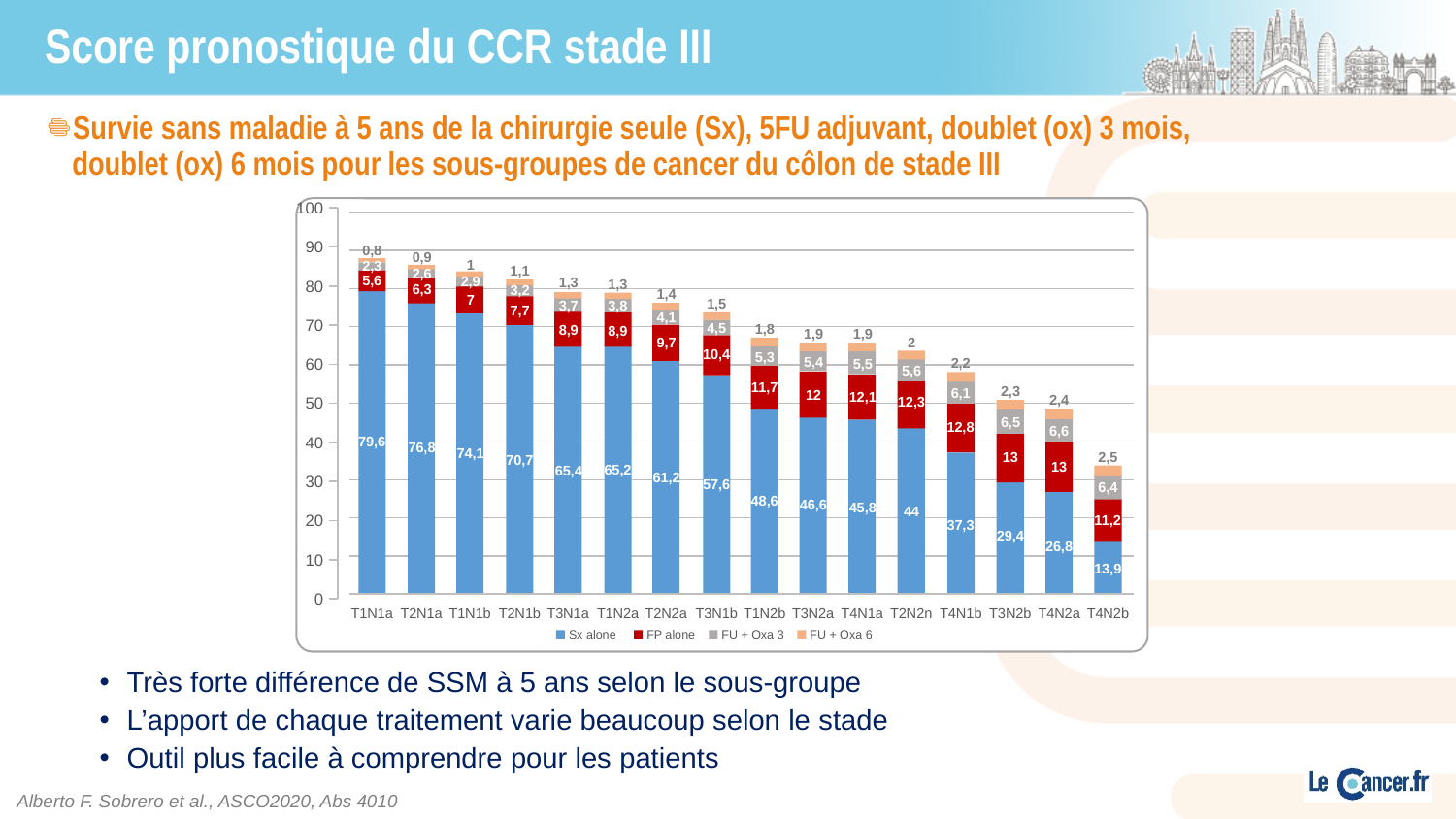
Which category has the highest 'Sx alone' value? T1N1a Which is larger, the 'FP alone' value for T3N2b or for T1N1a? T3N2b How many sub-group categories are shown on the x axis? 16 Which category has the lowest 'Sx alone' value? T4N2b Do the 'Sx alone' values rise or fall from left to right along the x axis? fall What is the difference between the 'Sx alone' values for T1N1a and T4N2b? 65,7 What type of chart is shown on the slide? stacked bar chart What is the total of the stacked bar for T4N2b? 34 How many series does the legend list? 4 What is the value of 'FP alone' for T4N1b? 12,8 What is the value of 'Sx alone' for T1N1a? 79,6 What is the value of 'FU + Oxa 6' for T4N2b? 2,5